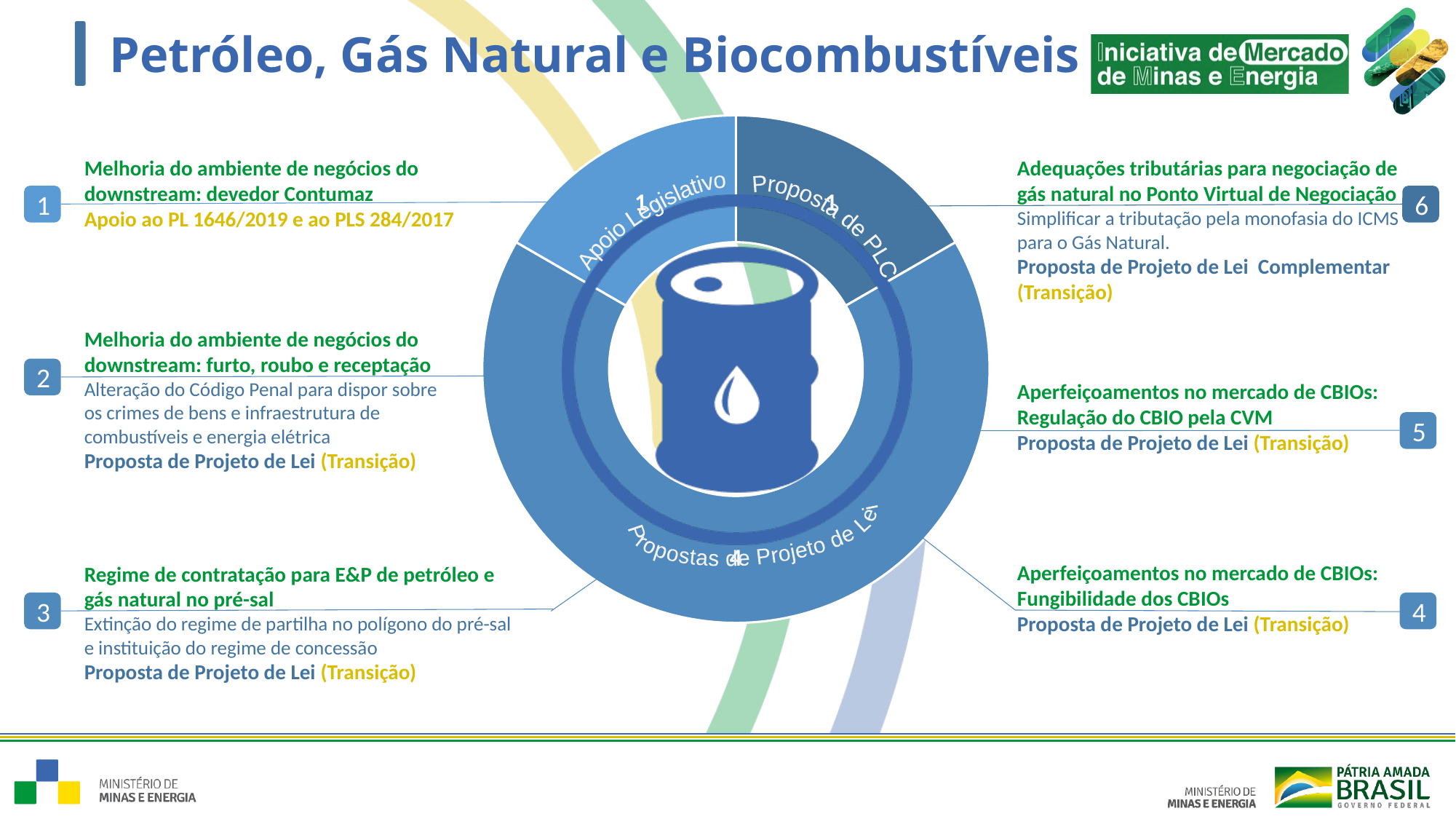
What value is shown on the 'Apoio Legislativo' segment? 1 Which segment of the doughnut chart is the largest? Propostas de Projeto de Lei What is the total of all the values shown on the doughnut chart segments? 6 What kind of chart is shown in the centre of the slide? Doughnut (pie) chart What value is shown on the 'Propostas de Projeto de Lei' segment? 4 How many segments does the doughnut chart have? 3 What icon is shown in the centre of the doughnut chart? An oil barrel What value is shown on the 'Proposta de PLC' segment? 1 What is the difference between the 'Propostas de Projeto de Lei' value and the 'Apoio Legislativo' value? 3 Which is larger, the 'Propostas de Projeto de Lei' segment or the 'Proposta de PLC' segment? Propostas de Projeto de Lei Which segment of the doughnut chart is coloured light blue? Apoio Legislativo